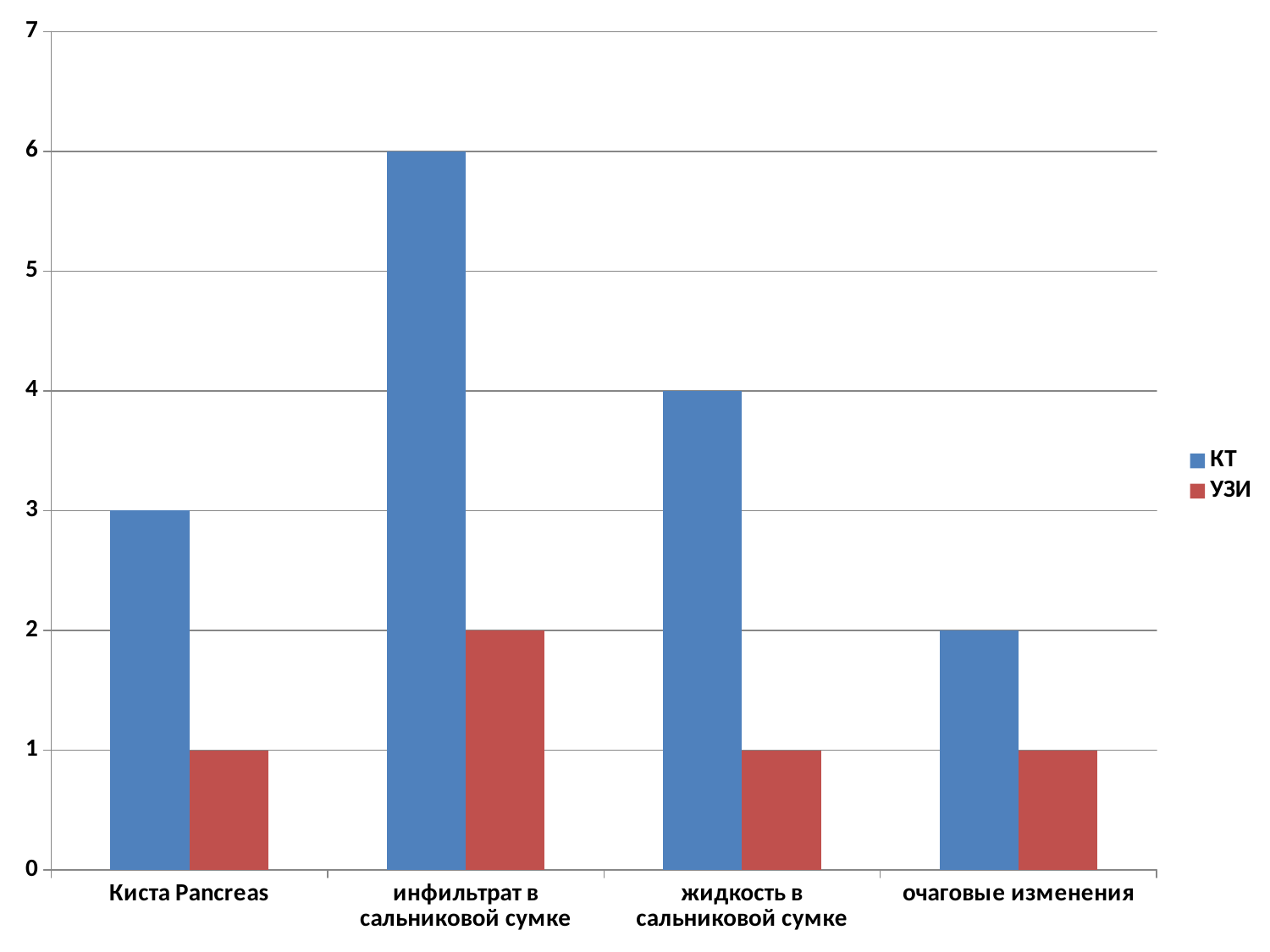
How many categories are shown on the x axis? 4 What is the КТ value for Киста Pancreas? 3 What is the difference between the КТ and УЗИ values for инфильтрат в сальниковой сумке? 4 Which category has the lowest КТ value? очаговые изменения What is the КТ value for жидкость в сальниковой сумке? 4 What is the КТ value for инфильтрат в сальниковой сумке? 6 How many series does the legend list? 2 What is the УЗИ value for инфильтрат в сальниковой сумке? 2 What is the УЗИ value for очаговые изменения? 1 Which is larger for жидкость в сальниковой сумке, the КТ value or the УЗИ value? КТ What kind of chart is shown on the slide? bar chart Which category has the highest КТ value? инфильтрат в сальниковой сумке